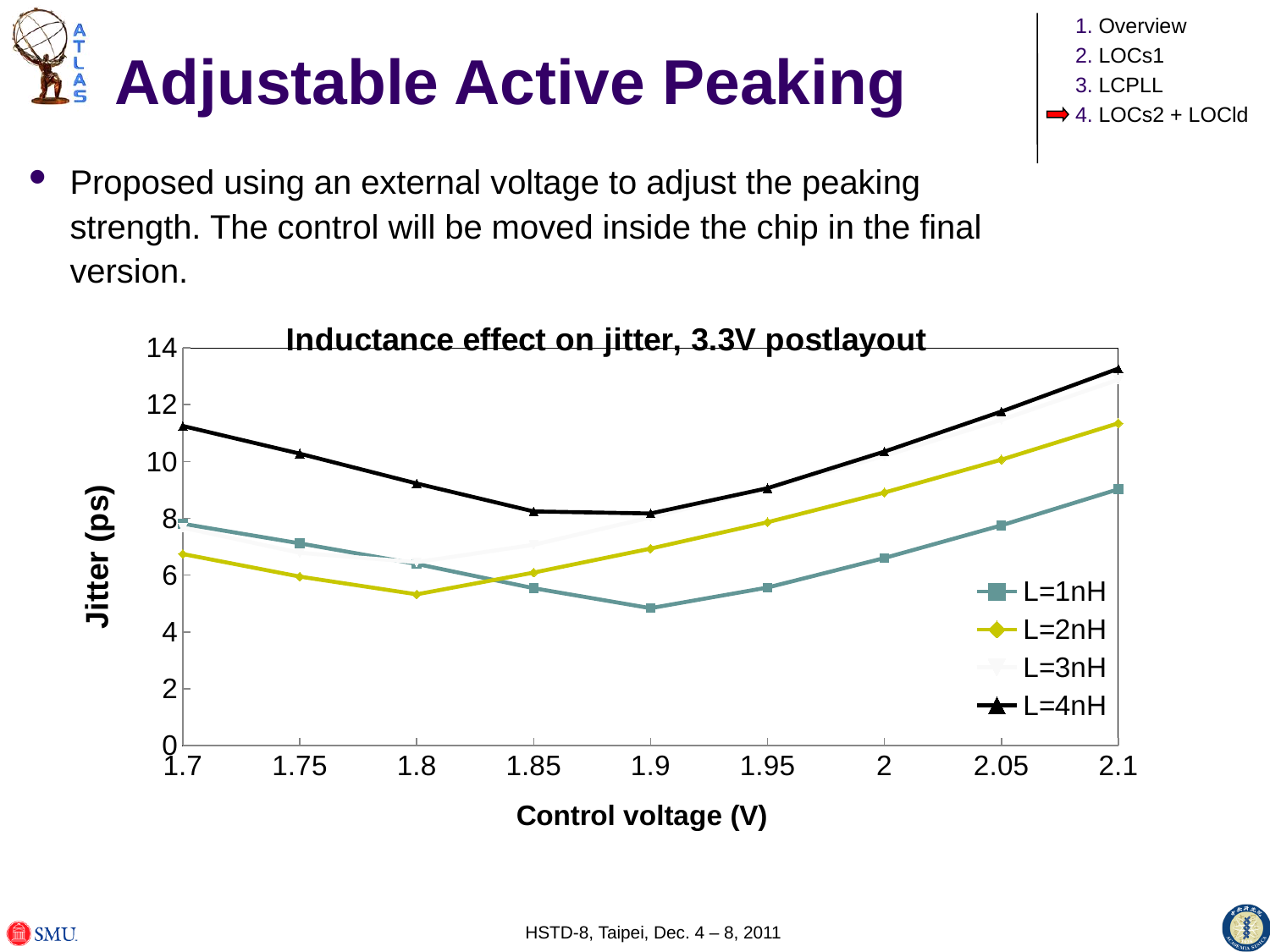
Which series has the highest jitter at a control voltage of 1.7 V? L=4nH How many series does the legend of the chart list? 4 What kind of chart is shown on the slide? line chart How many control voltage points are plotted along the x axis of the chart? 9 Is the jitter for L=2nH at a control voltage of 1.8 V greater or less than 6? less What is the title of the chart? Inductance effect on jitter, 3.3V postlayout Does the jitter for L=2nH rise or fall as the control voltage increases from 1.8 V to 2.1 V? rise Is the jitter for L=4nH at a control voltage of 1.7 V greater or less than 10? greater Is the jitter for L=1nH at a control voltage of 1.9 V greater or less than 6? less At a control voltage of 2.1 V, which series has the larger jitter, L=4nH or L=1nH? L=4nH Which series has the lowest jitter at a control voltage of 1.9 V? L=1nH